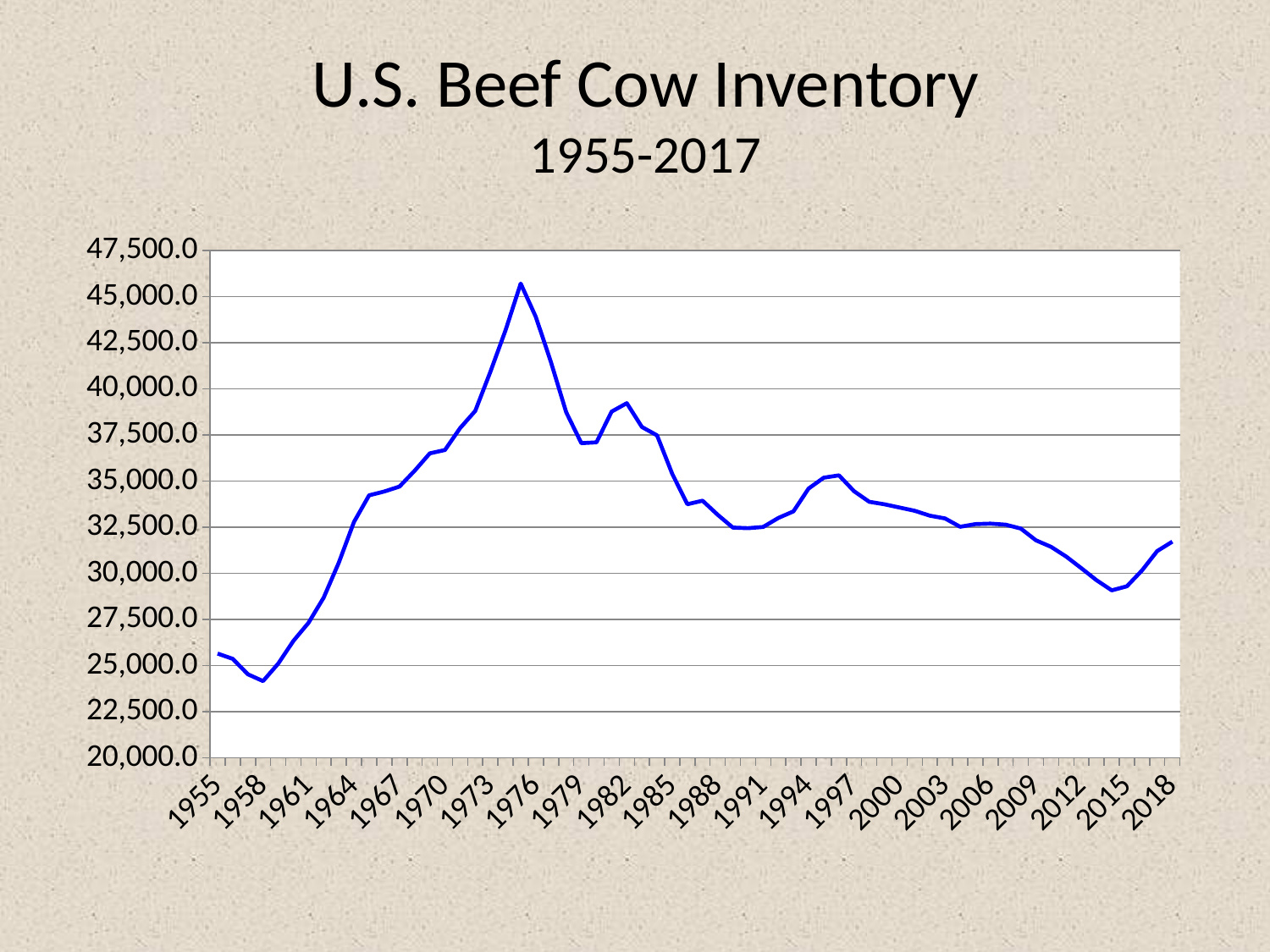
Is the value for 1985 greater or less than 40,000? less What is the title of the chart on the slide? U.S. Beef Cow Inventory Which is higher, the value for 1970 or the value for 2000? 1970 What kind of chart is shown on the slide? line chart Is the value for 2015 greater or less than 30,000? less Which is higher, the value for 1955 or the value for 2018? 2018 Is the highest point on the line greater or less than 45,000? greater Does the line generally rise or fall between 1958 and 1973? rise What range of years does the chart title say it covers? 1955-2017